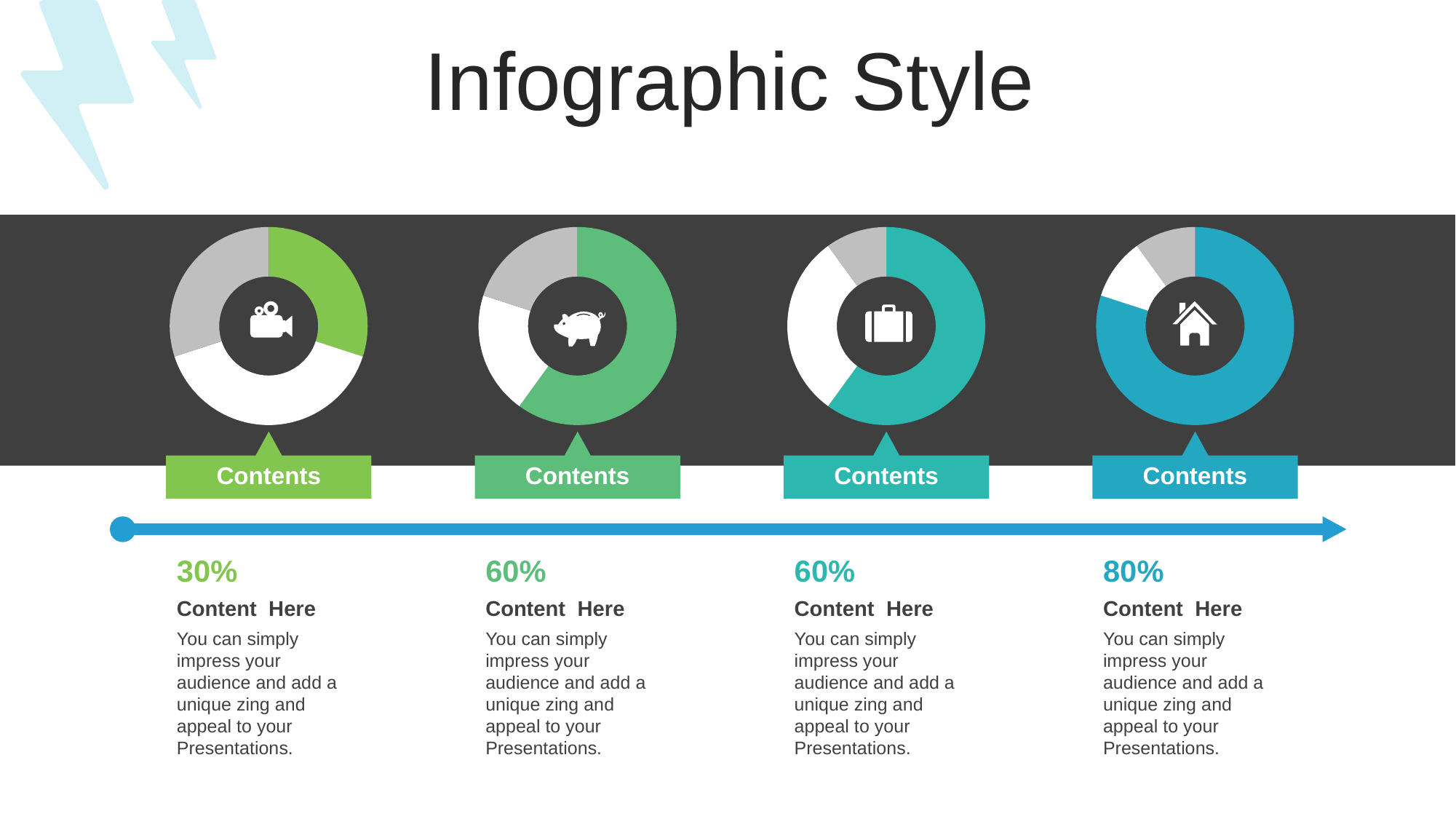
What percentage is shown for the second doughnut chart (with the piggy bank icon)? 60% What percentage is shown for the rightmost doughnut chart (with the house icon)? 80% What percentage is shown for the third doughnut chart (with the briefcase icon)? 60% Which is larger, the percentage for the leftmost doughnut chart or the percentage for the rightmost doughnut chart? The rightmost chart (80%) Is the coloured portion of the leftmost doughnut chart greater or less than 50%? less What percentage is shown for the leftmost doughnut chart (with the video camera icon)? 30% What colour is the main filled segment of the rightmost doughnut chart? Blue Which doughnut chart has the lowest percentage? The leftmost chart (video camera icon), 30% Which doughnut chart has the highest percentage? The rightmost chart (house icon), 80% What is the difference between the percentage of the rightmost doughnut chart and the leftmost doughnut chart? 50 percentage points How many doughnut charts are on the slide? 4 What kind of charts are shown on the dark band of the slide? Doughnut charts